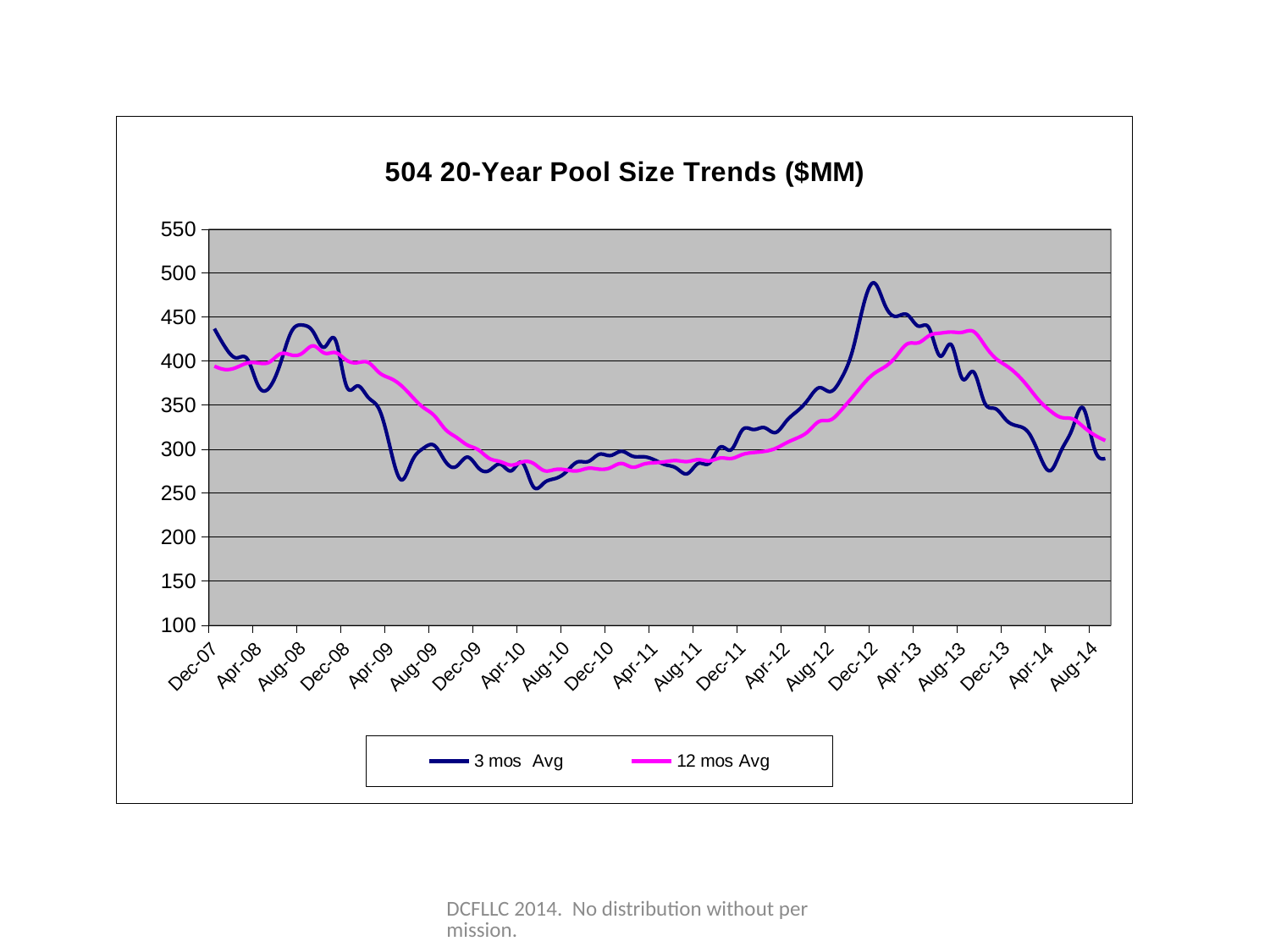
Does the 12 mos Avg line rise or fall between Aug-13 and Aug-14? Fall Is the highest point of the 3 mos Avg line greater or less than 450? greater Is the value of the 12 mos Avg line at Aug-14 greater or less than 350? less How many date labels are shown on the x axis? 21 At Aug-13, which series has the higher value, 3 mos Avg or 12 mos Avg? 12 mos Avg Is the value of the 3 mos Avg line at Aug-10 greater or less than 300? less Which series reaches the highest value anywhere on the chart? 3 mos Avg What is the title of the chart? 504 20-Year Pool Size Trends ($MM) How many series does the legend list? 2 What type of chart is shown on the slide? Line chart Which series is drawn in magenta (pink)? 12 mos Avg